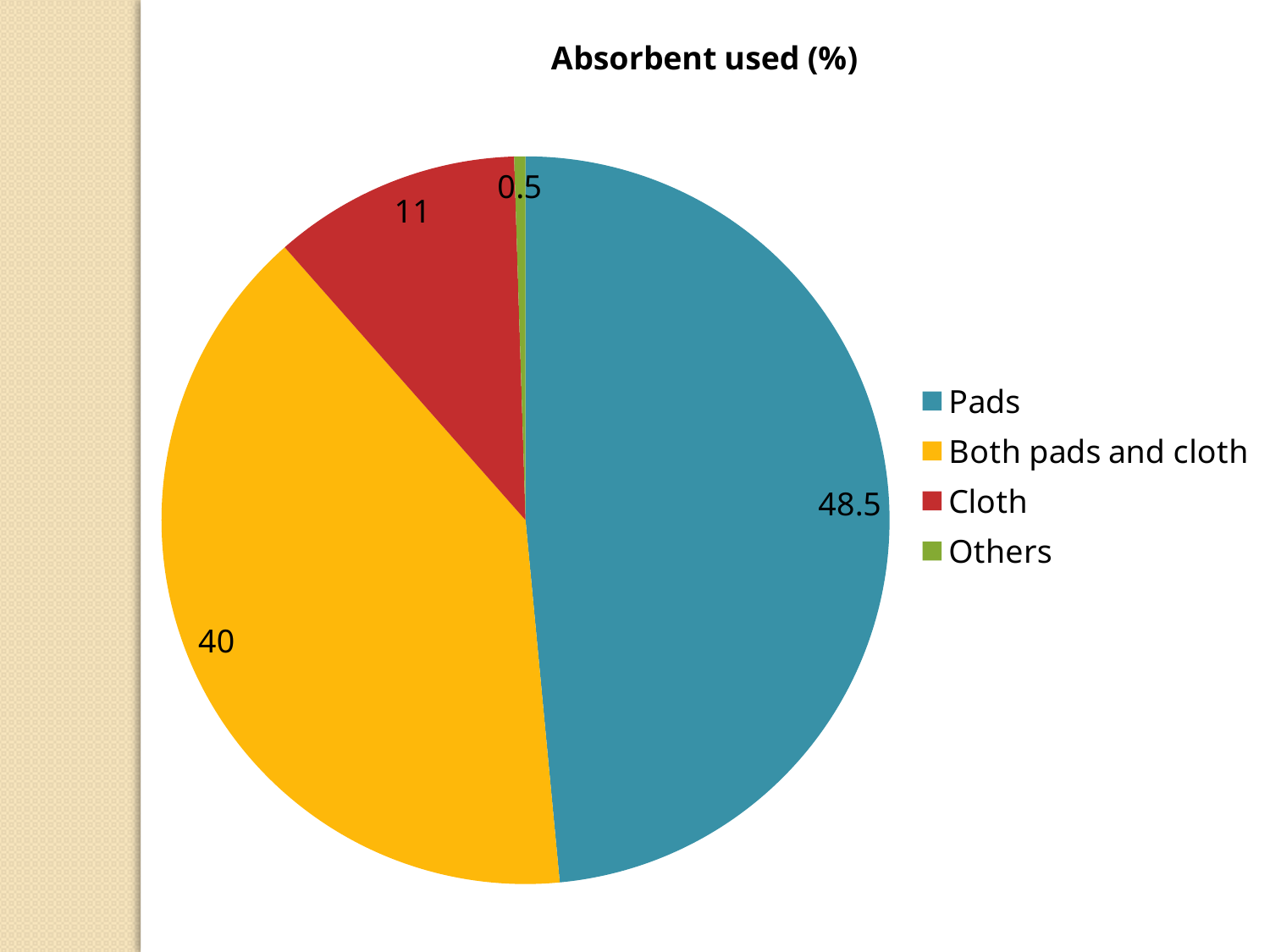
Which category has the largest slice of the pie? Pads Which category has the smallest slice of the pie? Others What is the value for Both pads and cloth? 40 What is the difference between the values for Pads and Both pads and cloth? 8.5 Which is larger, the value for Cloth or the value for Both pads and cloth? Both pads and cloth What is the value for Others? 0.5 What is the difference between the values for Cloth and Others? 10.5 How many categories does the pie chart show? 4 What is the title of the chart? Absorbent used (%) What is the value for Pads in the Absorbent used (%) chart? 48.5 What is the value for Cloth? 11 What kind of chart is shown on the slide? Pie chart